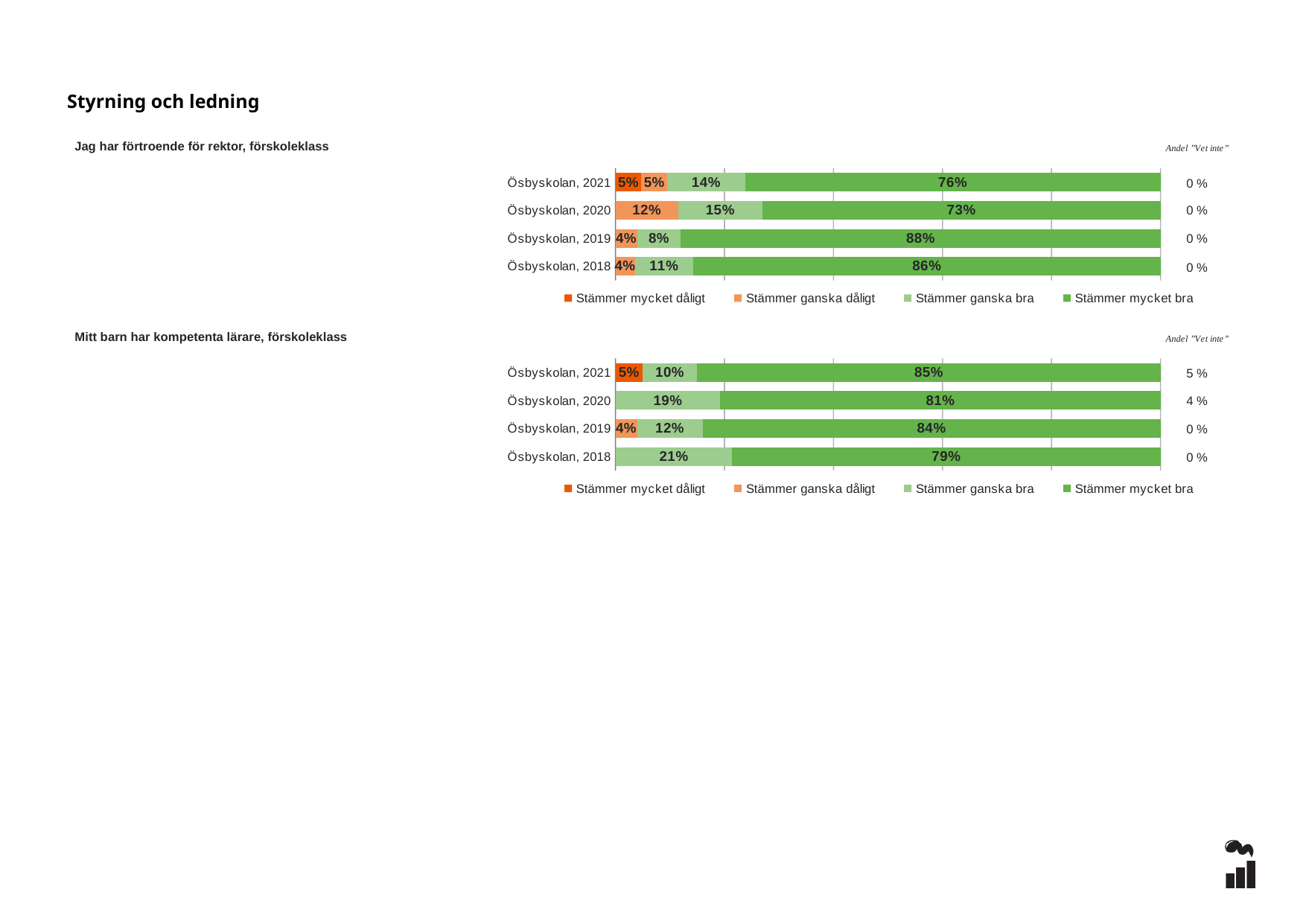
In the chart 'Jag har förtroende för rektor, förskoleklass', what is the value for 'Stämmer ganska dåligt' for Ösbyskolan, 2020? 12% In the chart 'Mitt barn har kompetenta lärare, förskoleklass', what is the value for 'Stämmer mycket bra' for Ösbyskolan, 2020? 81% In the chart 'Mitt barn har kompetenta lärare, förskoleklass', what is the value for 'Stämmer ganska bra' for Ösbyskolan, 2018? 21% In the chart 'Jag har förtroende för rektor, förskoleklass', which year has the highest value for 'Stämmer mycket bra'? Ösbyskolan, 2019 In the chart 'Jag har förtroende för rektor, förskoleklass', what is the value for 'Stämmer mycket bra' for Ösbyskolan, 2021? 76% In the chart 'Jag har förtroende för rektor, förskoleklass', which year has the lowest value for 'Stämmer mycket bra'? Ösbyskolan, 2020 In the chart 'Mitt barn har kompetenta lärare, förskoleklass', what is the 'Andel "Vet inte"' value shown for Ösbyskolan, 2021? 5 % How many series does the legend of the chart 'Mitt barn har kompetenta lärare, förskoleklass' list? 4 What kind of chart is 'Jag har förtroende för rektor, förskoleklass'? Stacked bar chart In the chart 'Mitt barn har kompetenta lärare, förskoleklass', which is larger: 'Stämmer mycket bra' for Ösbyskolan, 2021 or for Ösbyskolan, 2018? Ösbyskolan, 2021 In the chart 'Jag har förtroende för rektor, förskoleklass', what is the difference between the 'Stämmer mycket bra' values for Ösbyskolan, 2019 and Ösbyskolan, 2021? 12% How many categories (bars) are shown in the chart 'Jag har förtroende för rektor, förskoleklass'? 4